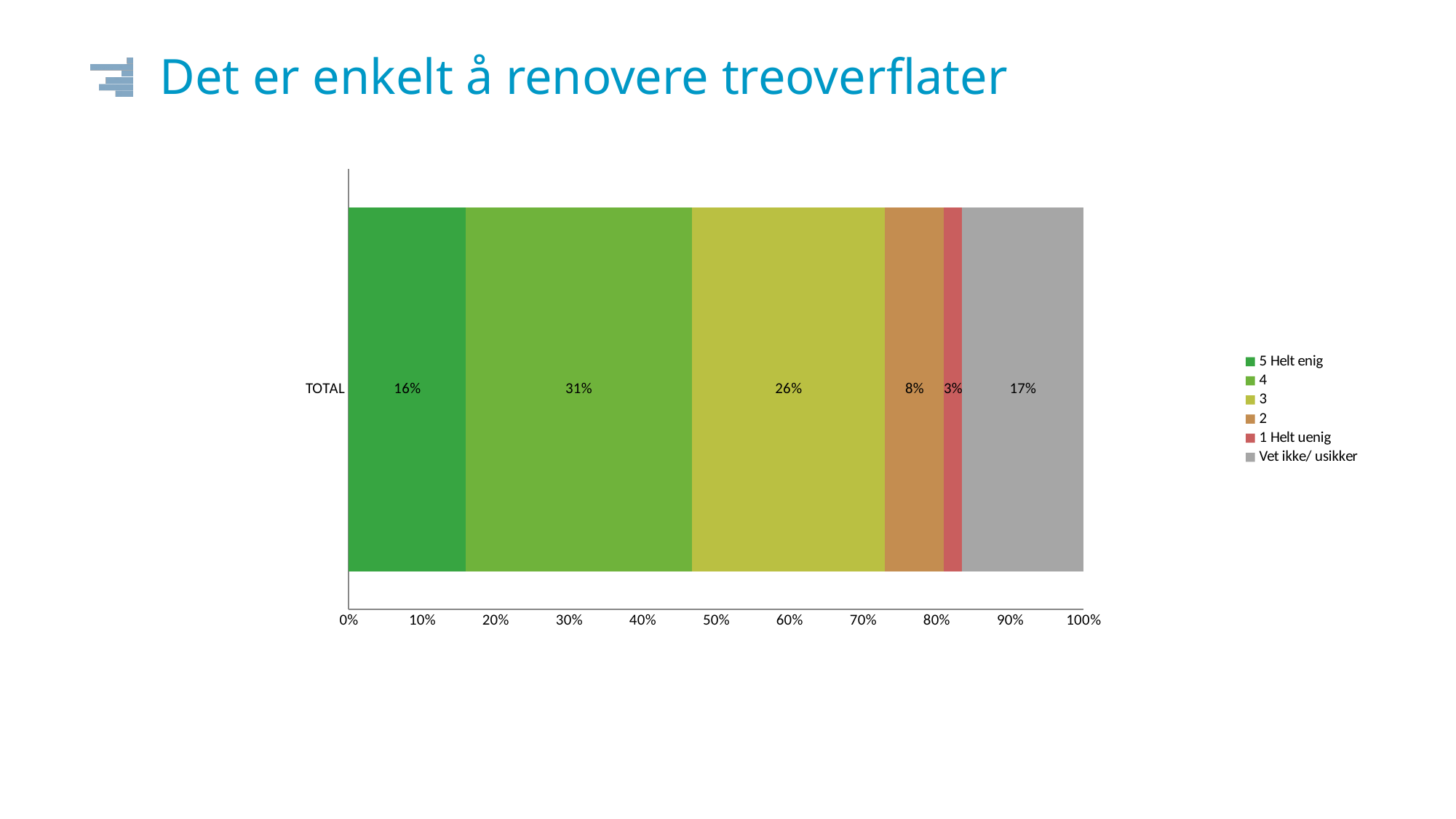
What is the title of the slide? Det er enkelt å renovere treoverflater Which response category has the largest share in the TOTAL bar? 4 What is the difference between the share for "4" and the share for "3"? 5% What share of respondents answered "Vet ikke/ usikker"? 17% What is the combined share of "5 Helt enig" and "4"? 47% What is the value for "1 Helt uenig"? 3% What is the value for the "4" series in the TOTAL bar? 31% Which is larger, the share for "5 Helt enig" or the share for "Vet ikke/ usikker"? Vet ikke/ usikker What kind of chart is shown on the slide? Stacked bar chart How many series does the legend list? 6 Which response category has the smallest share in the TOTAL bar? 1 Helt uenig What percentage of respondents answered "5 Helt enig"? 16%